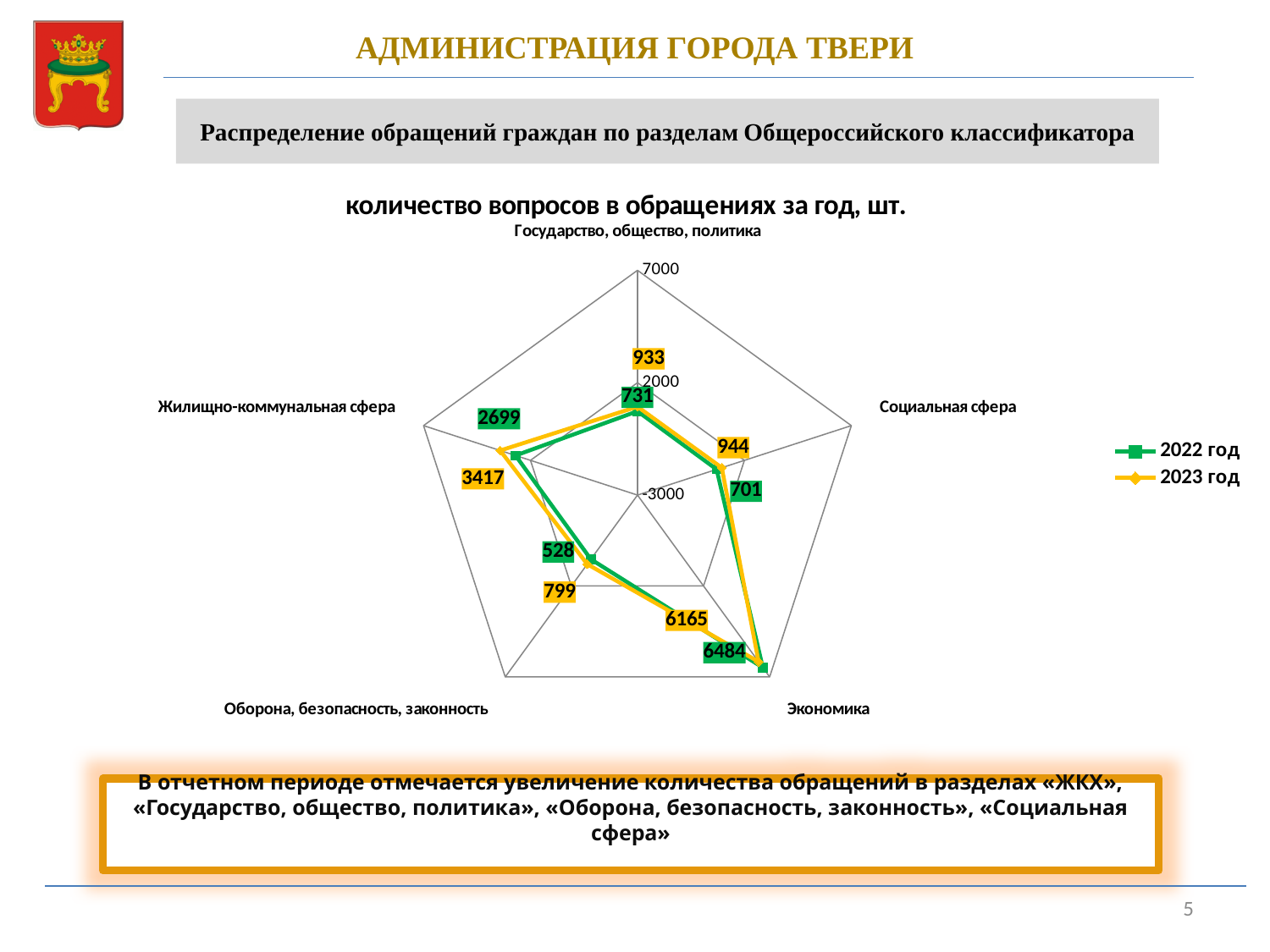
What is the value for Жилищно-коммунальная сфера in the 2023 год series? 3417 How many series does the legend list? 2 Which series has the larger value for Экономика, 2022 год or 2023 год? 2022 год How many categories (axes) does the radar chart have? 5 Which category has the highest value in the 2023 год series? Экономика What is the value for Экономика in the 2022 год series? 6484 What kind of chart is shown on the slide? radar chart What is the title of the chart? количество вопросов в обращениях за год, шт. What is the value for Социальная сфера in the 2022 год series? 701 What is the value for Оборона, безопасность, законность in the 2023 год series? 799 What is the difference between the 2023 год and 2022 год values for Жилищно-коммунальная сфера? 718 Which category has the lowest value in the 2022 год series? Оборона, безопасность, законность